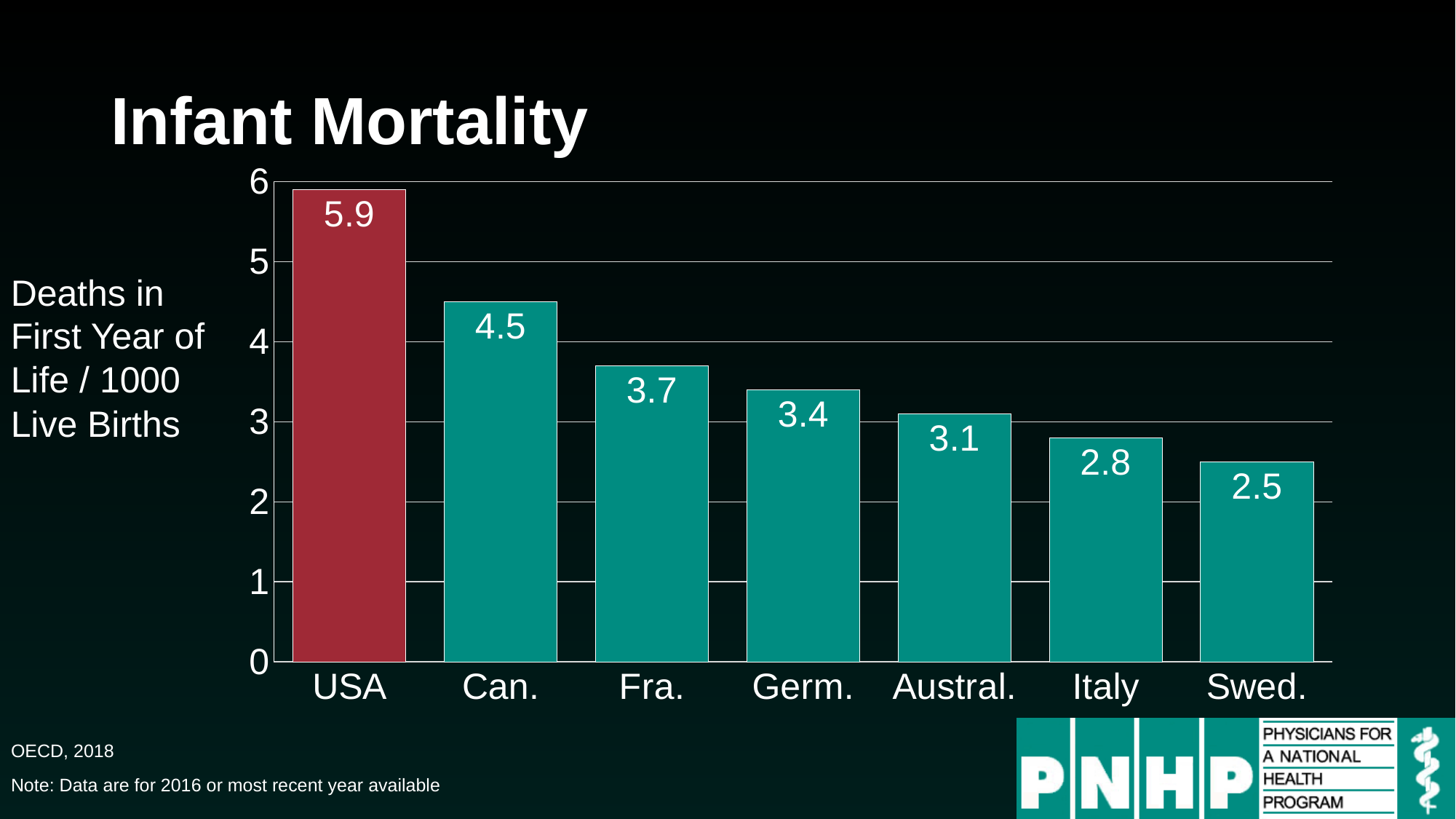
What is the value shown for Germ.? 3.4 Is the value for Can. greater or less than 4? greater What kind of chart is shown on the slide? Bar chart Which has a larger value, Austral. or Germ.? Germ. How many countries are shown on the chart? 7 What is the difference between the values for Fra. and Italy? 0.9 What is the infant mortality value shown for the USA? 5.9 Which country has the highest infant mortality on the chart? USA Do the values rise or fall from left to right across the chart? Fall What is the value shown for Swed.? 2.5 What is the difference between the values for the USA and Can.? 1.4 Which country has the lowest infant mortality on the chart? Swed.